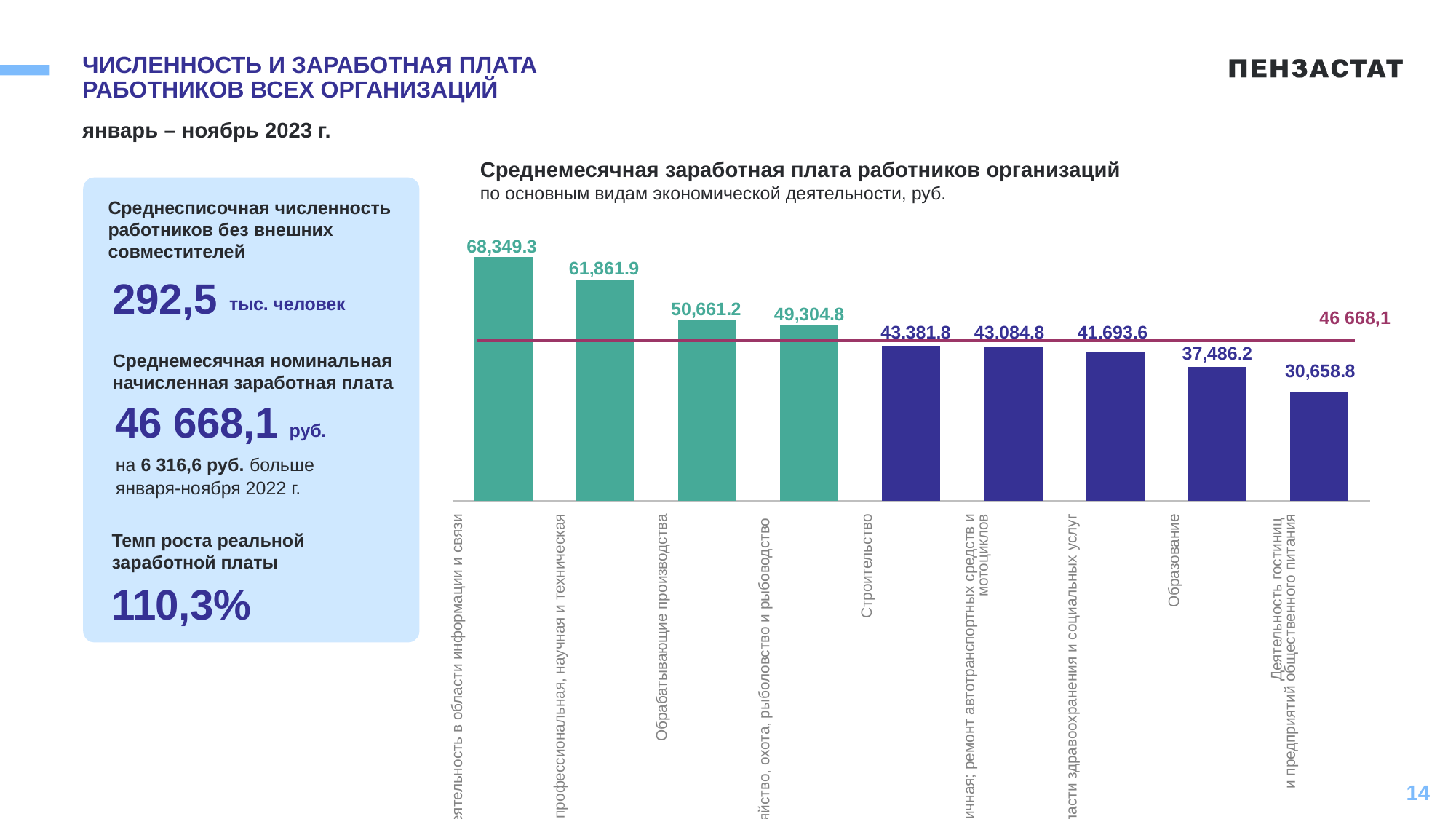
What is the average monthly wage shown for Строительство? 43,381.8 What kind of chart is shown on the slide? bar chart What is the average monthly wage shown for Обрабатывающие производства? 50,661.2 Which is larger, the value for Обрабатывающие производства or for Строительство? Обрабатывающие производства What is the value of the highest bar in the chart? 68,349.3 What is the difference between the values for Строительство and Образование? 5,895.6 Do the bar values rise or fall from left to right across the chart? fall What value is marked by the horizontal line across the chart? 46 668,1 What is the average monthly wage shown for Образование? 37,486.2 What is the difference between the values for Обрабатывающие производства and Образование? 13,175.0 Which category has the lowest average monthly wage in the chart? Деятельность гостиниц и предприятий общественного питания How many bars (types of economic activity) are plotted in the chart? 9